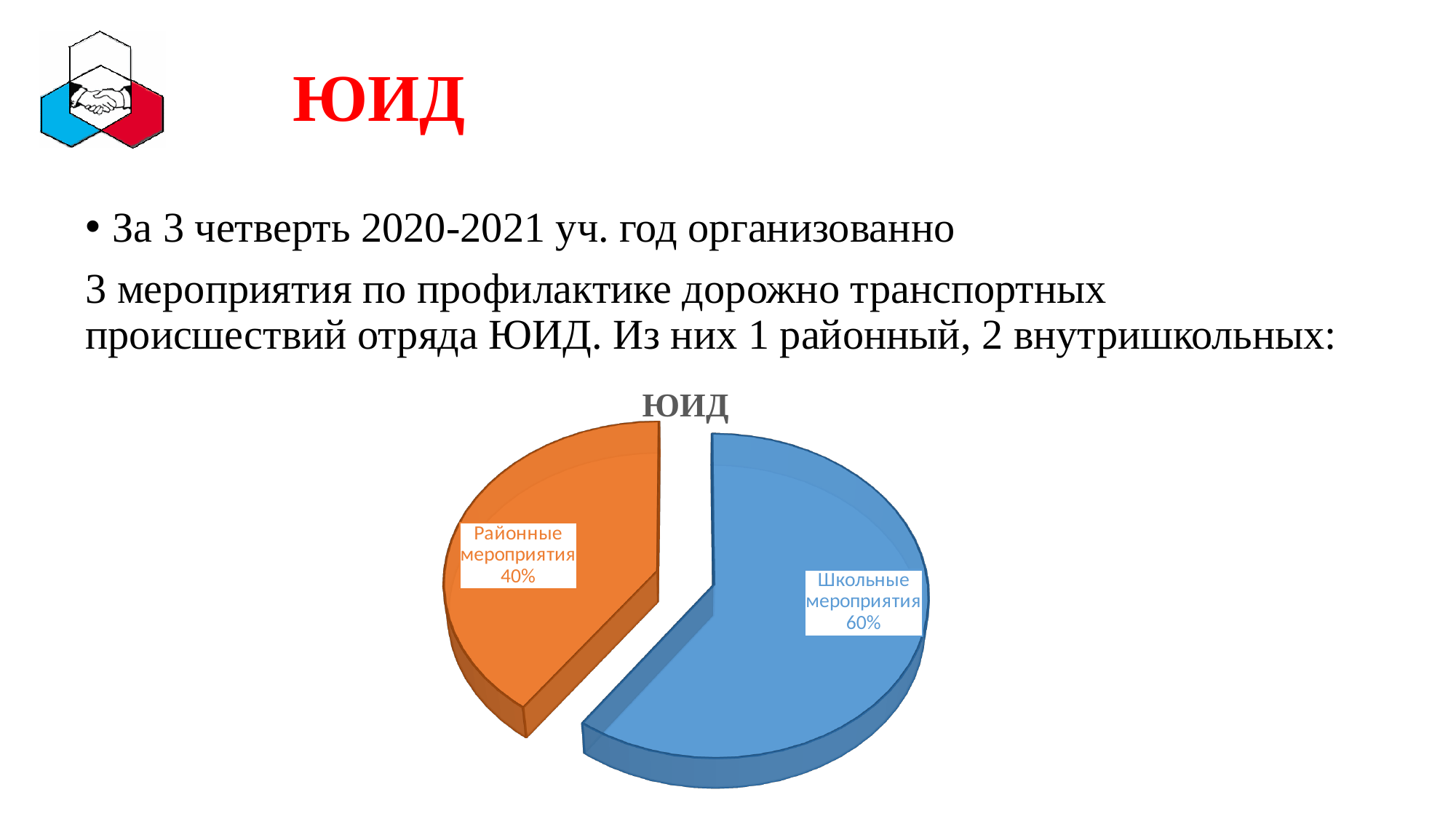
Which slice of the pie is the smallest? Районные мероприятия What share of the pie is labelled Районные мероприятия? 40% By how many percentage points does Школьные мероприятия exceed Районные мероприятия? 20% Which is larger: Школьные мероприятия or Районные мероприятия? Школьные мероприятия Which slice of the pie is the largest? Школьные мероприятия What kind of chart is shown on the slide? pie chart What share of the pie is labelled Школьные мероприятия? 60% What is the title of the chart? ЮИД What colour is the Районные мероприятия slice? orange How many slices does the pie chart have? 2